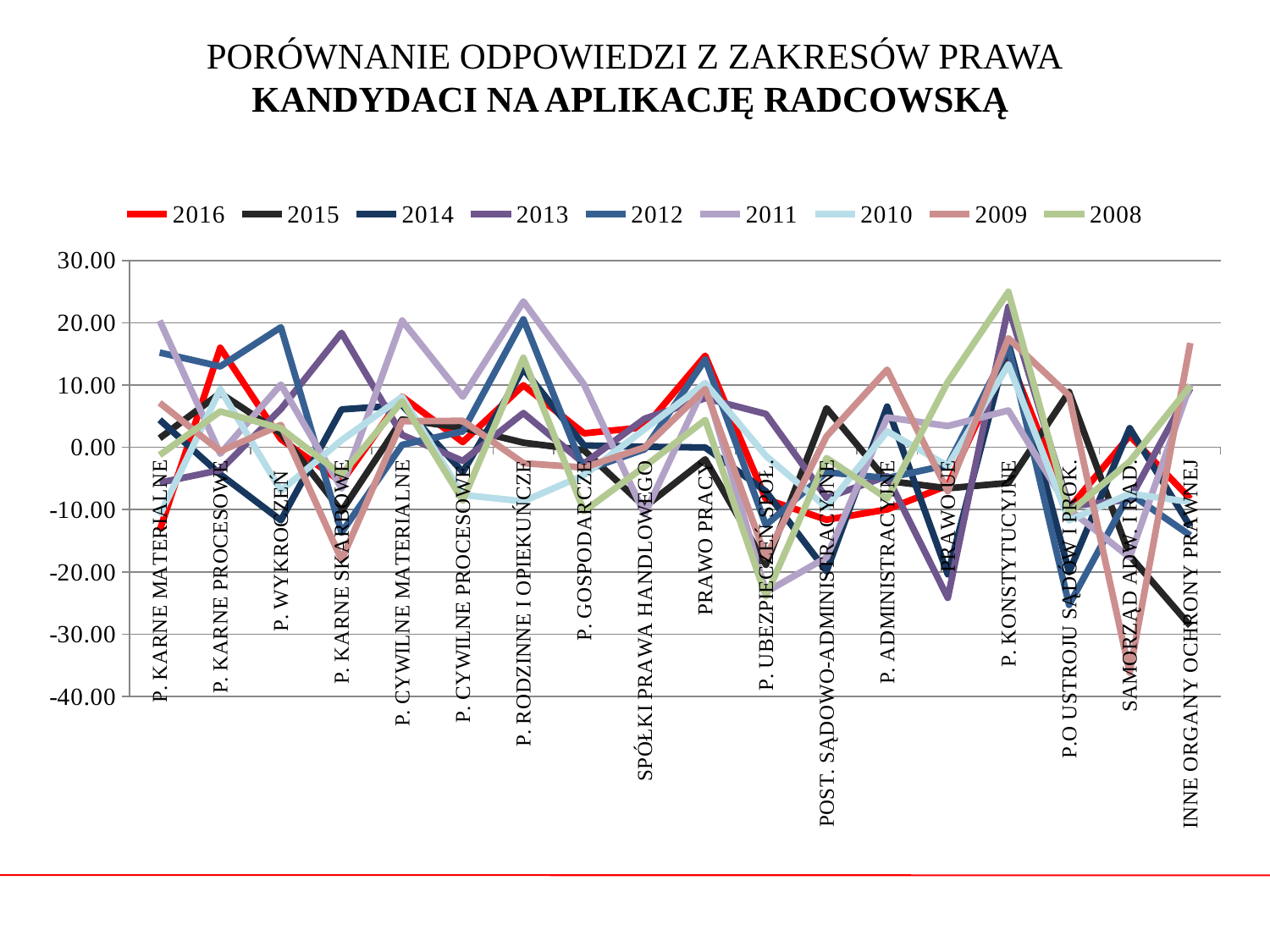
How many categories are plotted along the x axis? 18 Is the 2009 value for SAMORZĄD ADW. I RAD. greater or less than -30? less What kind of chart is shown on the slide? line chart How many series does the legend list? 9 Is the 2016 value for P. KARNE MATERIALNE greater or less than -10? less For the 2008 series, which category has the highest value? P. KONSTYTUCYJNE Is the 2011 value for P. RODZINNE I OPIEKUŃCZE greater or less than 20? greater Which year is drawn with the red line in the legend? 2016 For the 2009 series, which category has the lowest value? SAMORZĄD ADW. I RAD.